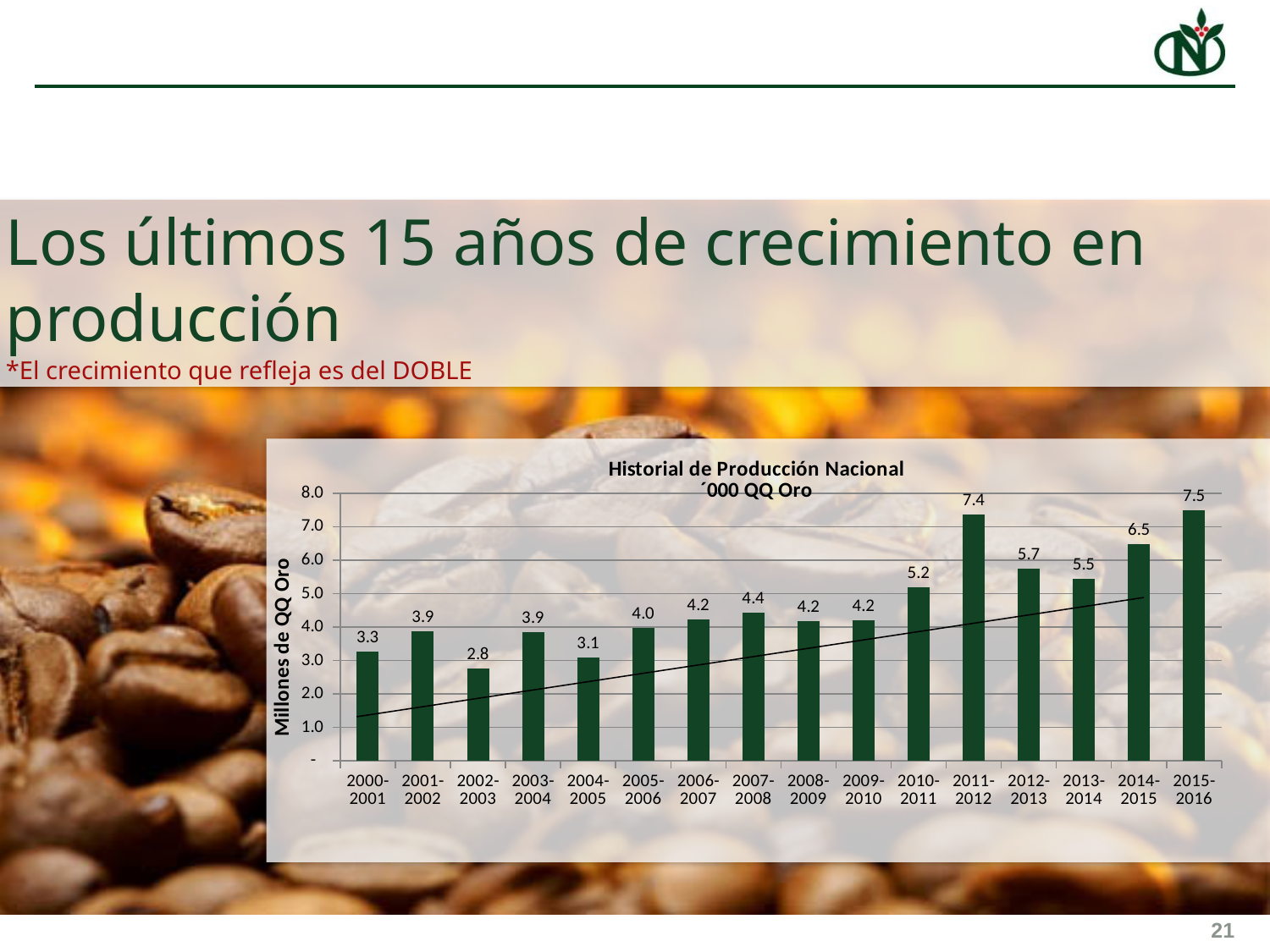
What is the value for 2000-2001? 3.3 Which is larger, the value for 2014-2015 or the value for 2013-2014? 2014-2015 What is the value for 2011-2012? 7.4 What kind of chart is shown on the slide? Bar chart What is the label of the vertical axis? Millones de QQ Oro Which period has the lowest value? 2002-2003 What is the difference between the values for 2011-2012 and 2012-2013? 1.7 Do the values generally rise or fall from 2000-2001 to 2015-2016? Rise What is the value for 2007-2008? 4.4 Which period has the highest value? 2015-2016 How many periods (bars) are shown in the chart? 16 What is the difference between the values for 2015-2016 and 2000-2001? 4.2